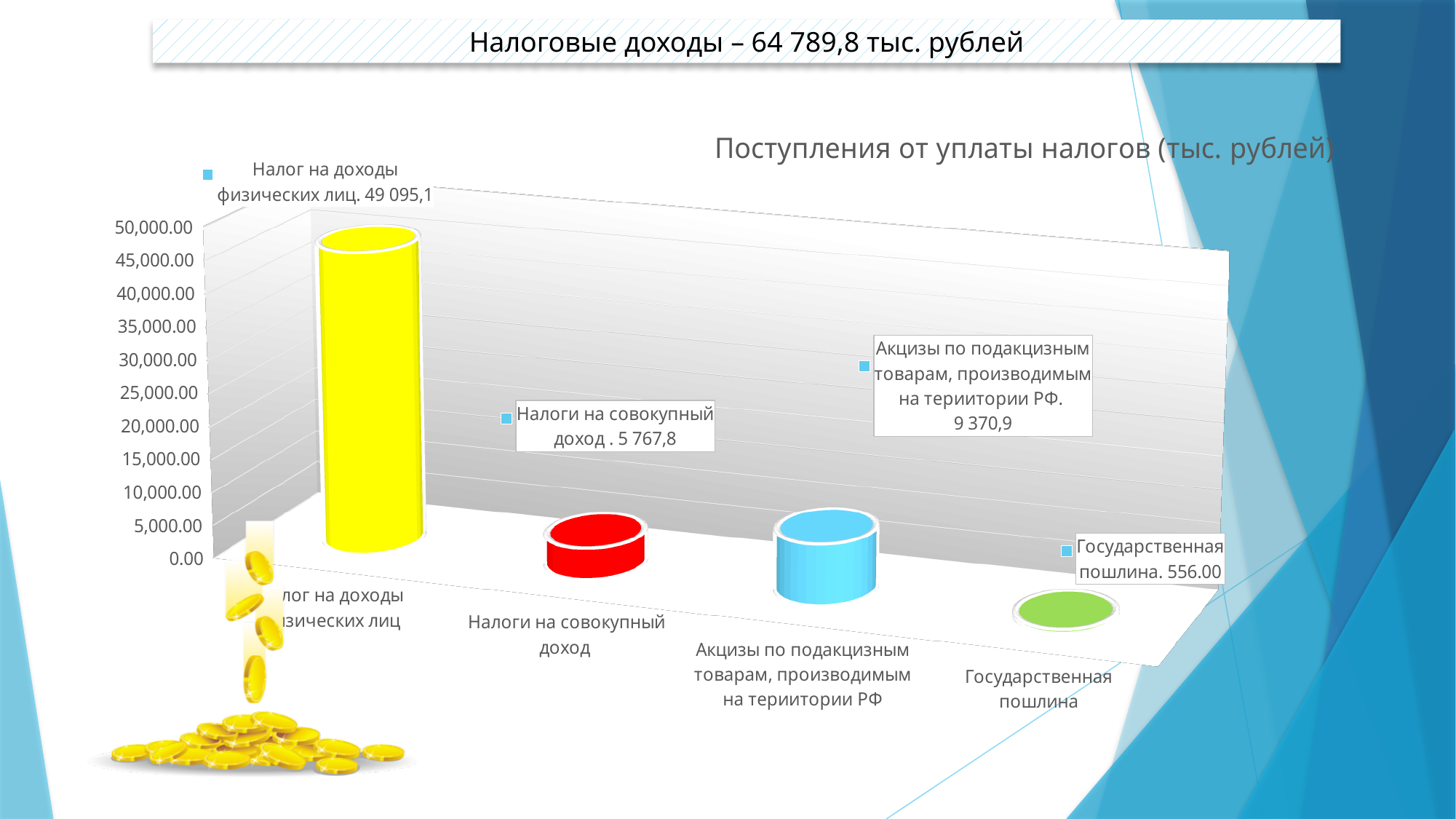
Which is larger: Налоги на совокупный доход or Акцизы по подакцизным товарам, производимым на территории РФ? Акцизы по подакцизным товарам, производимым на территории РФ What is the value for Налог на доходы физических лиц? 49 095,1 What is the difference between the values for Налог на доходы физических лиц and Налоги на совокупный доход? 43 327,3 How many categories are plotted in the chart? 4 What is the value for Акцизы по подакцизным товарам, производимым на территории РФ? 9 370,9 What is the value for Государственная пошлина? 556.00 Is the value for Налог на доходы физических лиц greater or less than 45,000.00? greater What is the value for Налоги на совокупный доход? 5 767,8 Which category has the highest value? Налог на доходы физических лиц What type of chart is shown on the slide? bar chart What is the title of the chart? Поступления от уплаты налогов (тыс. рублей) Which category has the lowest value? Государственная пошлина